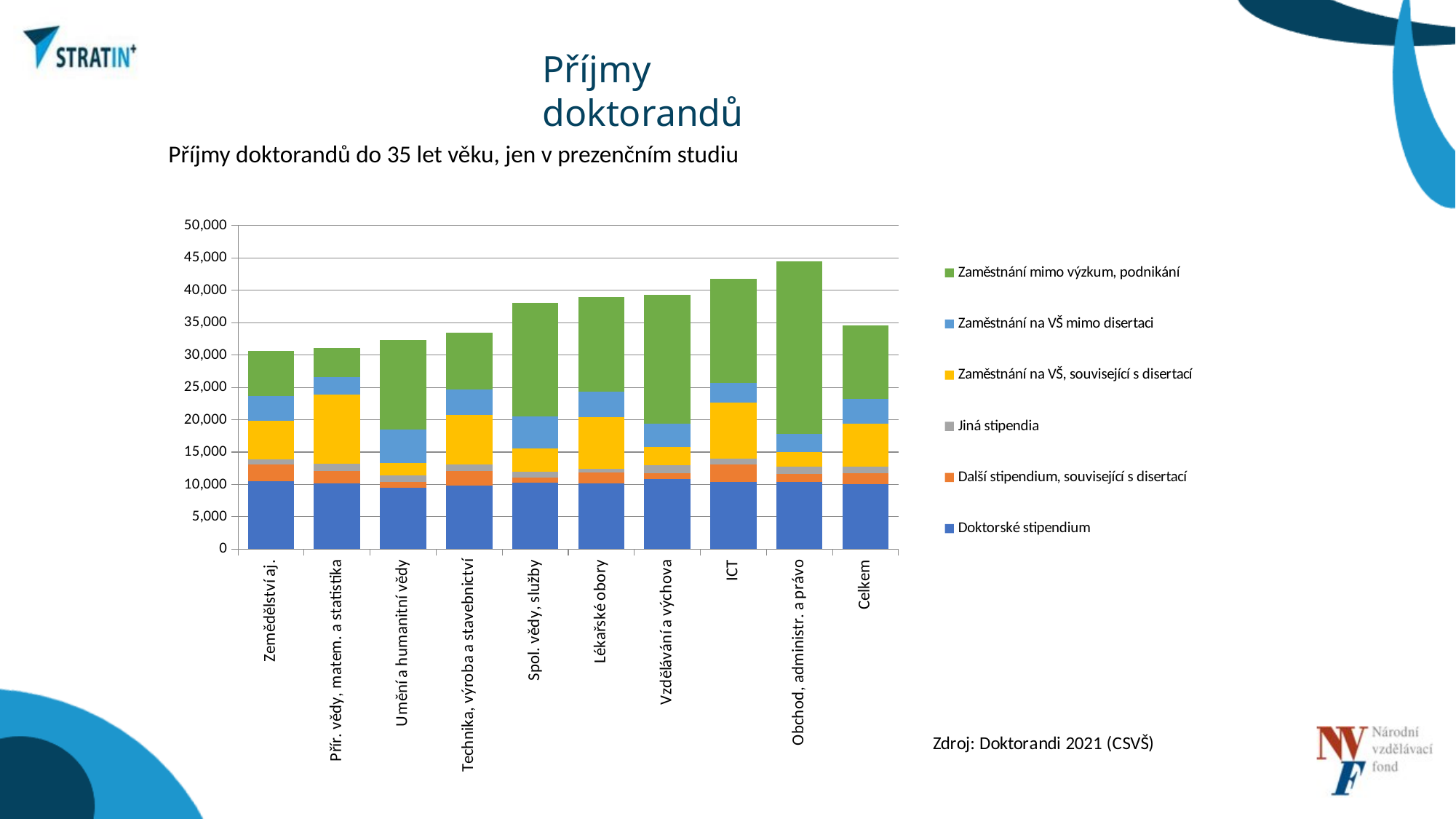
Is the total bar for Zemědělství aj. greater or less than 35,000? less Which category has the highest total bar? Obchod, administr. a právo How many series does the legend list? 6 Is the total bar for ICT greater or less than 40,000? greater Which has the larger total bar, Zemědělství aj. or Spol. vědy, služby? Spol. vědy, služby Is the total bar for Spol. vědy, služby greater or less than 40,000? less What kind of chart is shown on the slide? Stacked bar chart How many categories are shown on the x axis of the chart? 10 Which has the larger total bar, ICT or Obchod, administr. a právo? Obchod, administr. a právo Which series is listed first (at the top) in the legend? Zaměstnání mimo výzkum, podnikání